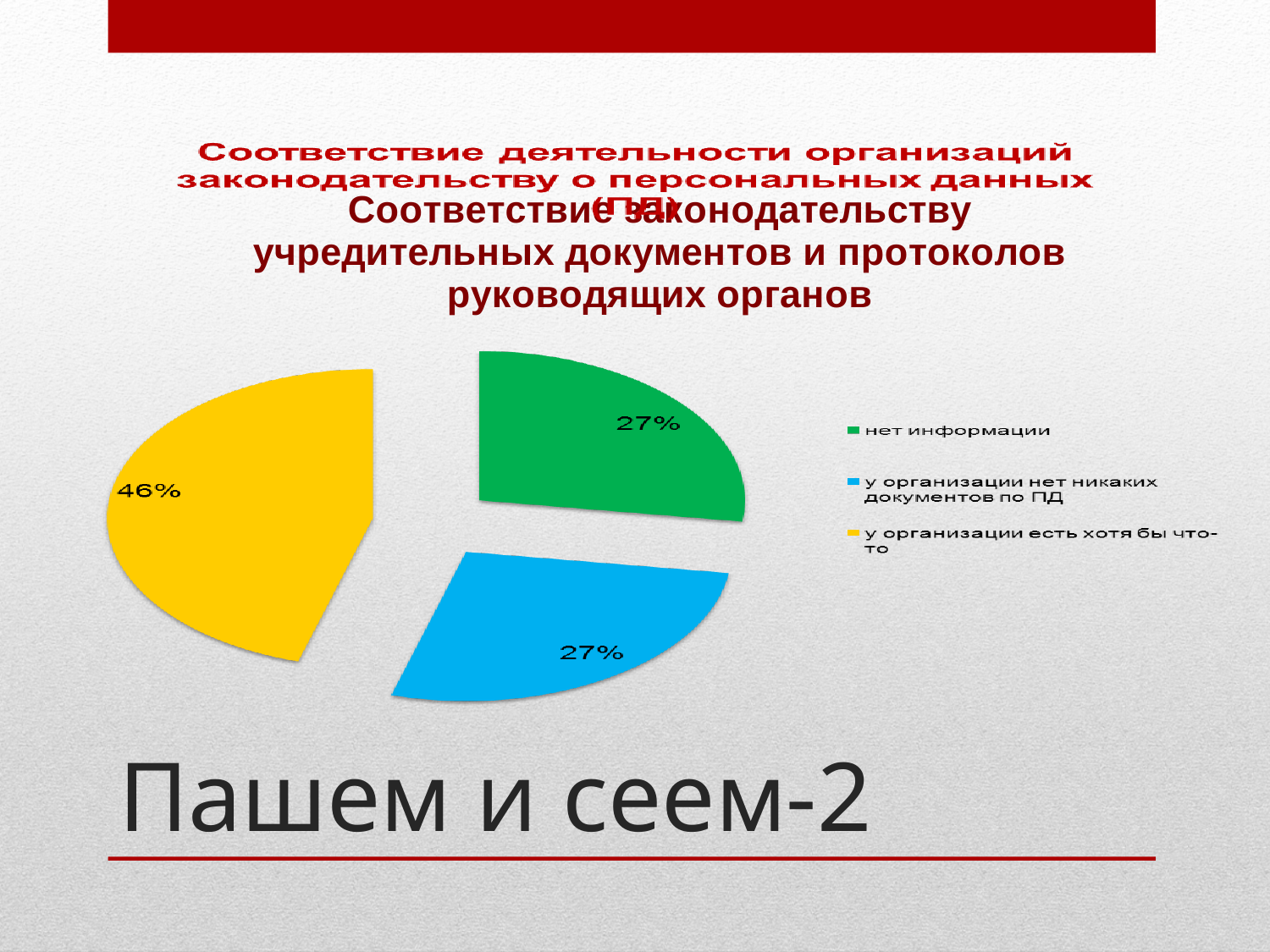
Which category has the largest slice of the pie? у организации есть хотя бы что-то What is the difference between the share for "у организации есть хотя бы что-то" and the share for "нет информации"? 19% What kind of chart is shown on the slide? pie chart What share of the pie does the slice "нет информации" represent? 27% What colour is the slice for "у организации есть хотя бы что-то"? yellow How many slices does the pie chart have? 3 What colour is the slice for "нет информации"? green What is the combined share of the two 27% slices? 54% What share of the pie does the slice "у организации нет никаких документов по ПД" represent? 27% How many entries does the legend list? 3 What share of the pie does the slice "у организации есть хотя бы что-то" represent? 46% Which is larger: the slice for "у организации есть хотя бы что-то" or the slice for "у организации нет никаких документов по ПД"? у организации есть хотя бы что-то